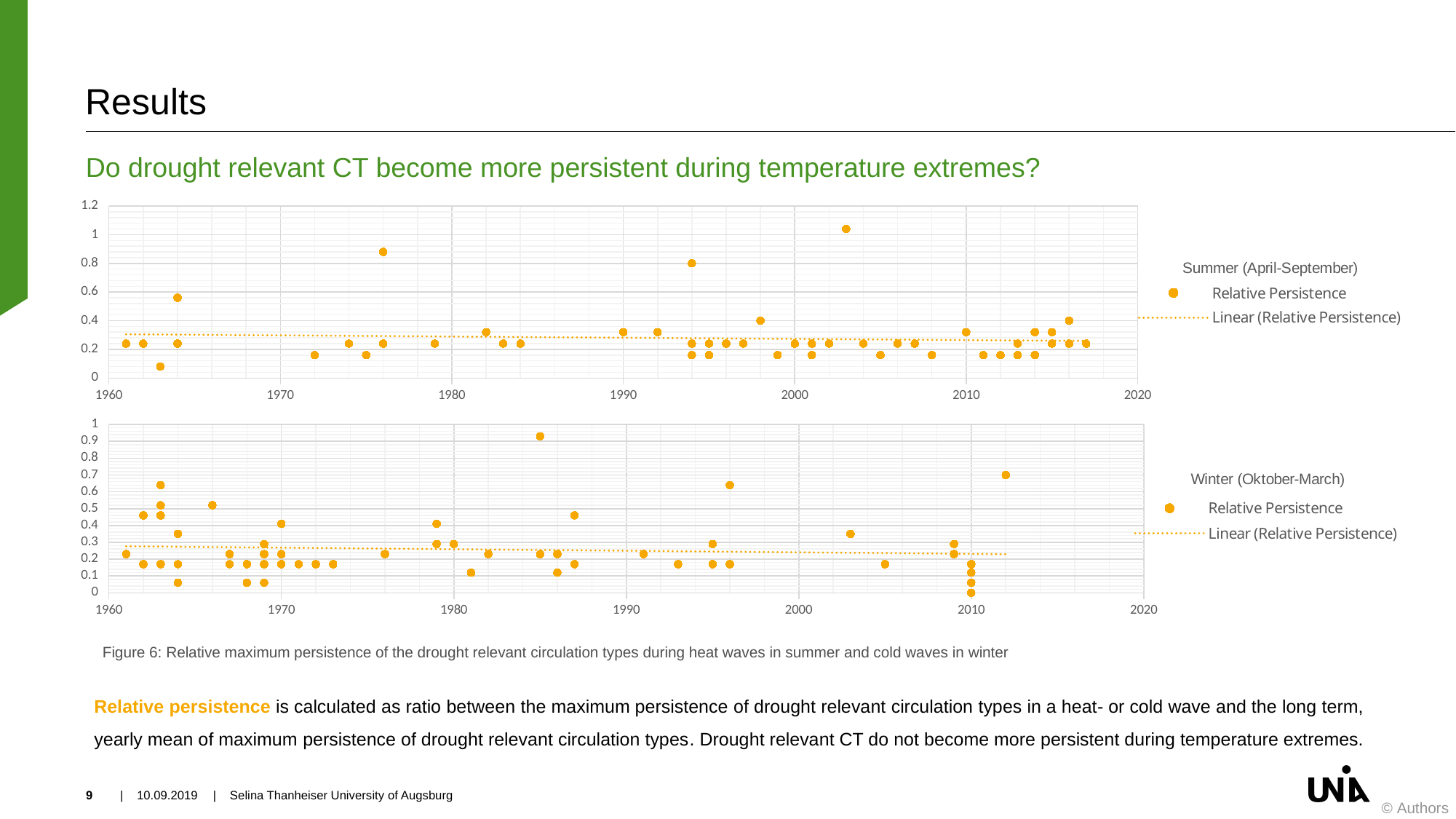
In the Winter (Oktober-March) chart, does the linear trend line rise or fall from 1960 to 2010? fall In the Winter (Oktober-March) chart, which year has the lowest relative persistence value? 2010 In the Summer (April-September) chart, which year has the highest relative persistence value? 2003 In the Summer (April-September) chart, is the value for 2003 greater or less than 0.8? greater In the Winter (Oktober-March) chart, which year has the highest relative persistence value? 1985 In the Summer (April-September) chart, which is larger, the value for 2003 or the value for 1976? 2003 How many entries does the legend of the Winter (Oktober-March) chart list? 2 In the Winter (Oktober-March) chart, is the value for 2012 greater or less than 0.6? greater What is the legend title of the top chart? Summer (April-September) What kind of chart is the Summer (April-September) chart? scatter chart